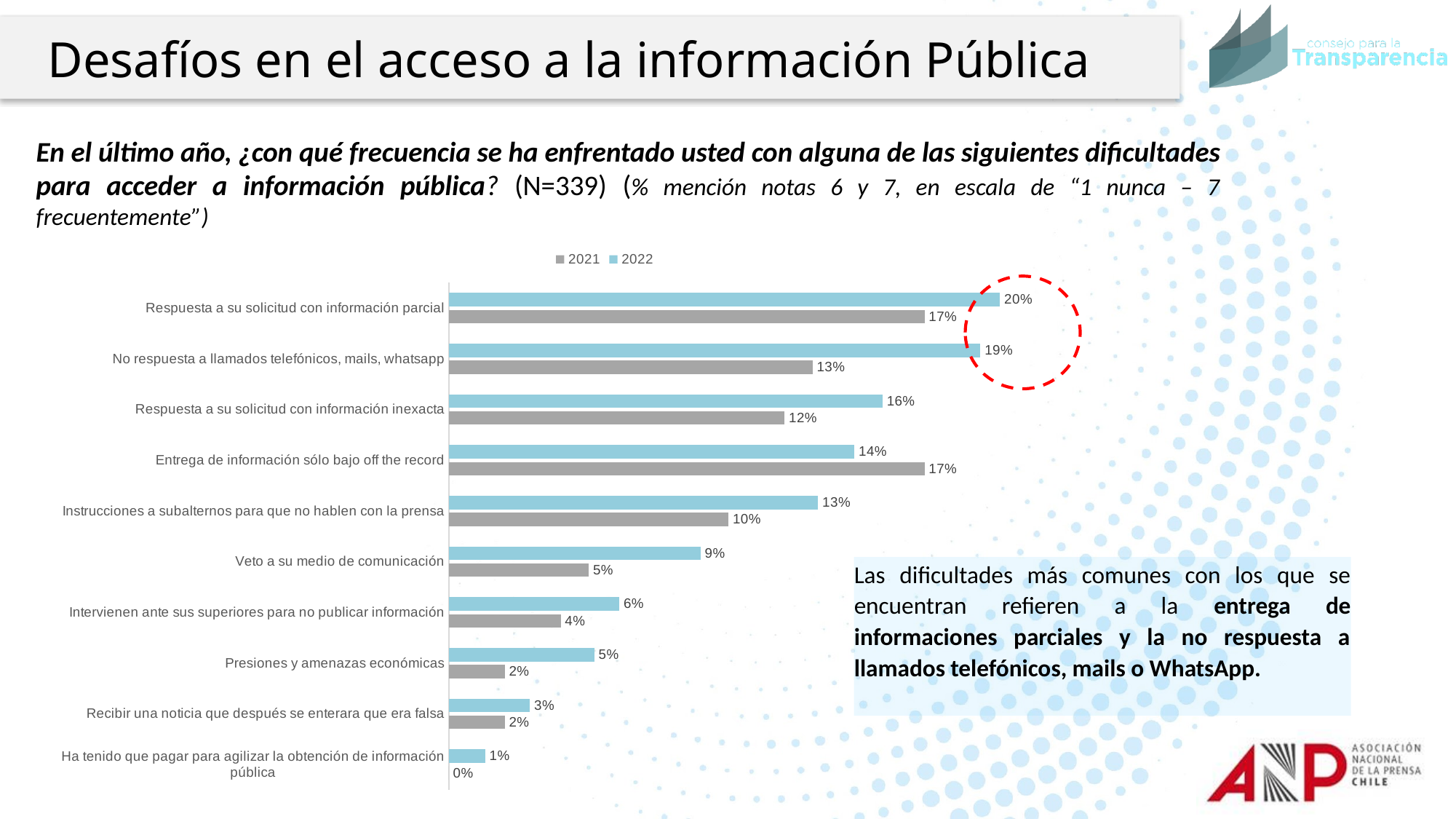
What is the 2022 value for "Veto a su medio de comunicación"? 9% What is the 2022 value for "Respuesta a su solicitud con información parcial"? 20% What is the 2021 value for "Entrega de información sólo bajo off the record"? 17% How many series does the legend list? 2 Which series is shown in blue in the chart? 2022 For "Entrega de información sólo bajo off the record", which year has the larger value, 2021 or 2022? 2021 What is the 2021 value for "No respuesta a llamados telefónicos, mails, whatsapp"? 13% What kind of chart is shown on the slide? Bar chart Which category has the highest 2022 value? Respuesta a su solicitud con información parcial Which category has the lowest 2021 value? Ha tenido que pagar para agilizar la obtención de información pública What is the difference between the 2022 and 2021 values for "No respuesta a llamados telefónicos, mails, whatsapp"? 6% How many categories are shown in the chart? 10